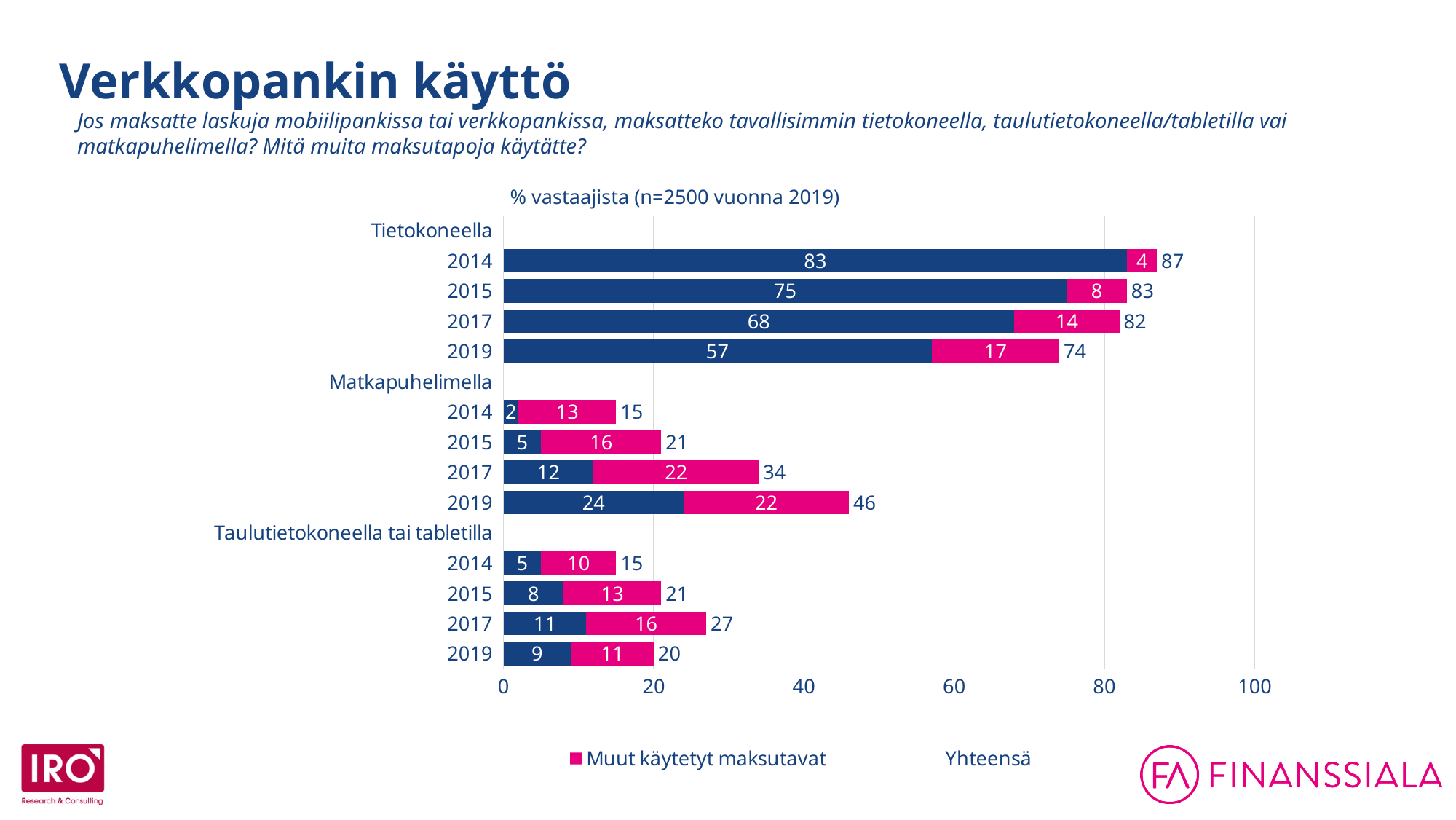
What is the 'Muut käytetyt maksutavat' value for Matkapuhelimella in 2017? 22 Which year has the highest total for Tietokoneella? 2014 Do the Tietokoneella totals rise or fall from 2014 to 2019? Fall What is the total (Yhteensä) value for Taulutietokoneella tai tabletilla in 2017? 27 What is the title of the chart? % vastaajista (n=2500 vuonna 2019) Which year has the lowest total for Matkapuhelimella? 2014 Do the Matkapuhelimella totals rise or fall from 2014 to 2019? Rise Which is larger in 2019: the total for Matkapuhelimella or the total for Taulutietokoneella tai tabletilla? Matkapuhelimella What is the total (Yhteensä) value for Tietokoneella in 2019? 74 What kind of chart is shown on the slide? Stacked bar chart How many bars are plotted in the chart? 12 What is the difference between the Tietokoneella totals for 2014 and 2019? 13